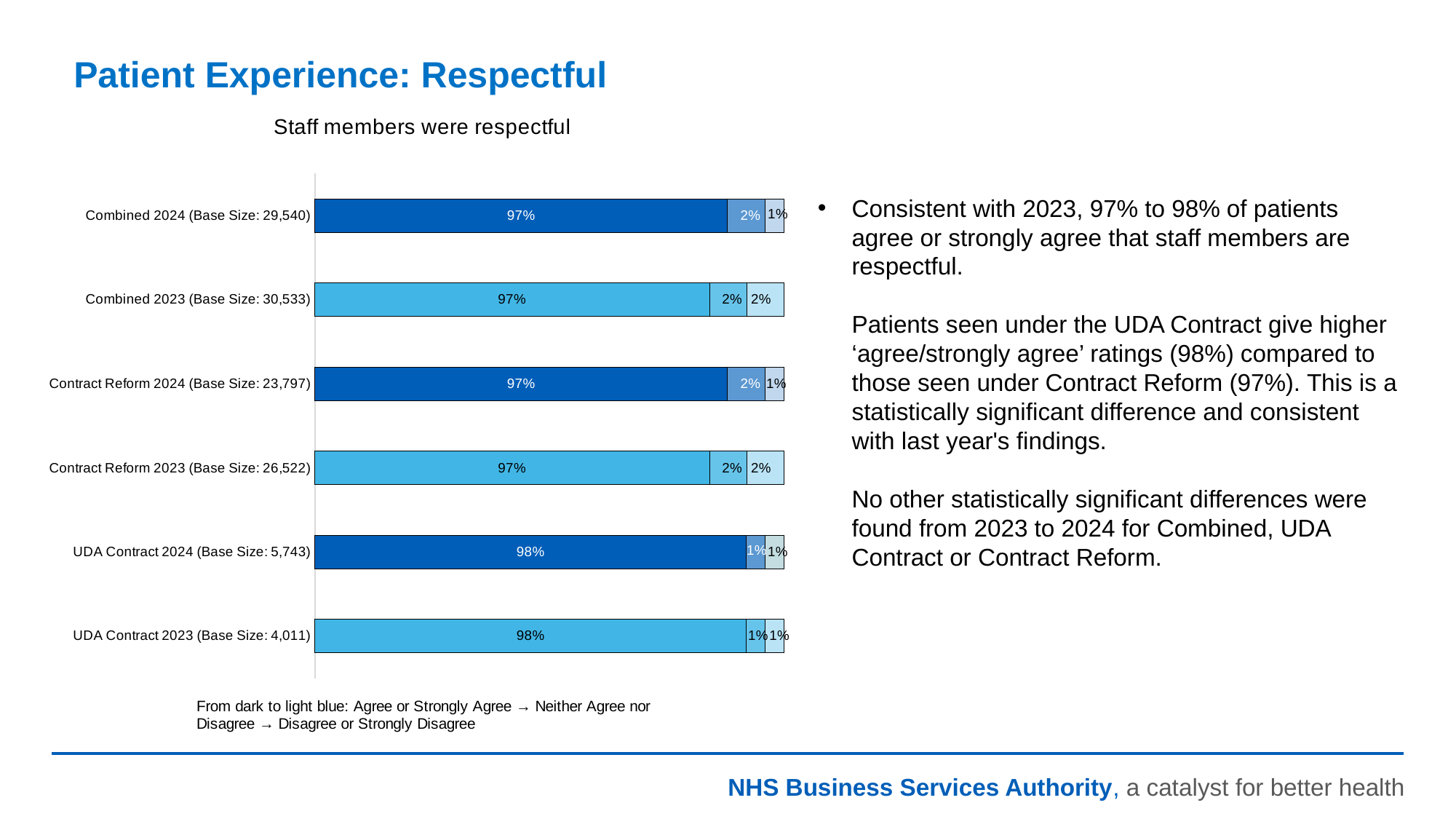
How many groups (bars) are shown in the chart? 6 What is the 'Neither Agree nor Disagree' value for UDA Contract 2023? 1% What is the title of the chart? Staff members were respectful What type of chart is shown on the slide? Stacked bar chart Which 2024 group has the highest 'Agree or Strongly Agree' percentage? UDA Contract 2024 What is the difference between the 'Agree or Strongly Agree' values for UDA Contract 2024 and Contract Reform 2024? 1% Which has a larger 'Agree or Strongly Agree' value, UDA Contract 2023 or Combined 2023? UDA Contract 2023 What is the total of the stacked bar for Combined 2024? 100% What percentage of patients in Combined 2024 agree or strongly agree that staff members were respectful? 97% What is the 'Agree or Strongly Agree' value for UDA Contract 2024? 98% What is the 'Disagree or Strongly Disagree' value for Combined 2023? 2% What is the 'Neither Agree nor Disagree' value for Contract Reform 2024? 2%